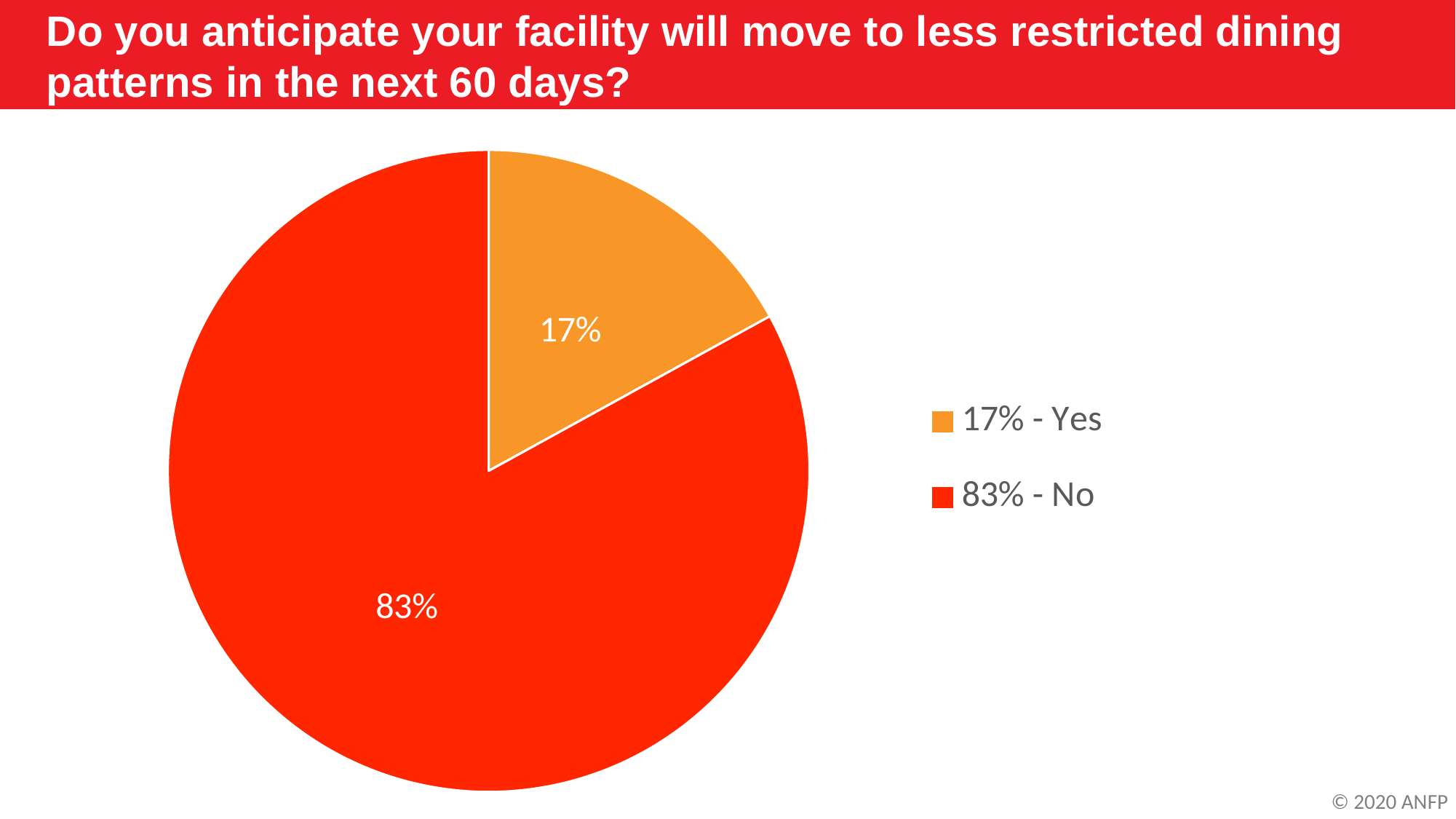
What percentage of respondents answered No? 83% Which response has the smallest share of the pie? Yes Which response has the largest share of the pie? No What is the difference in percentage points between the No and Yes responses? 66 What percentage of respondents answered Yes? 17% What share of the pie does the Yes slice represent? 17% How many entries does the legend list? 2 How many slices does the pie chart have? 2 What colour is the slice representing No? red What question does the chart title ask? Do you anticipate your facility will move to less restricted dining patterns in the next 60 days? What kind of chart is shown on the slide? pie chart Which is larger, the share for Yes or the share for No? No